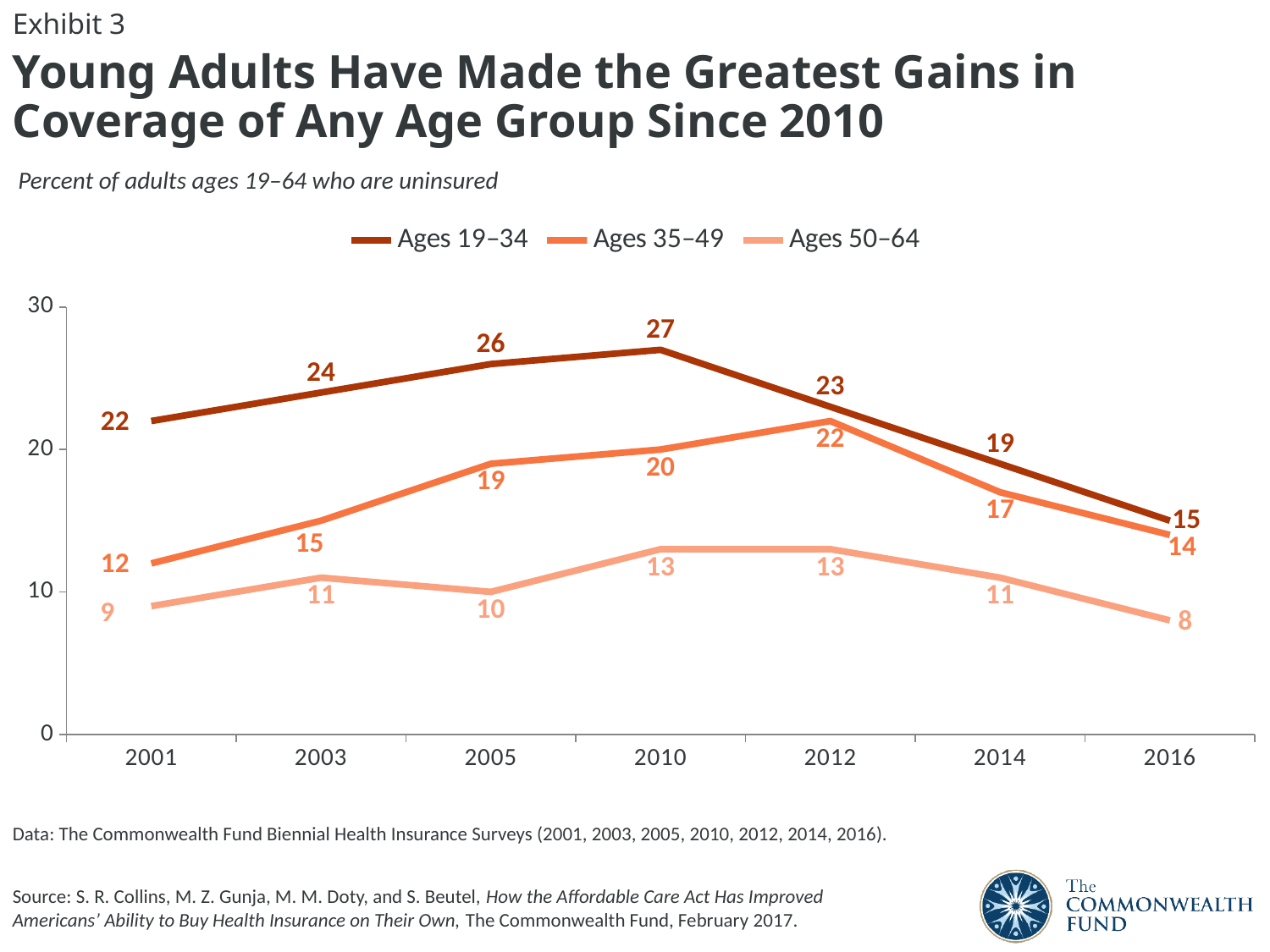
Did the Ages 35–49 uninsured rate rise or fall between 2012 and 2016? Fall How many series does the legend list? 3 By how many percentage points did the Ages 19–34 uninsured rate fall from 2010 to 2016? 12 In which year did the Ages 19–34 series reach its highest value? 2010 In which year was the Ages 50–64 series at its lowest value? 2016 How many years are shown on the x axis? 7 Which series had the higher value in 2001, Ages 19–34 or Ages 35–49? Ages 19–34 What is the difference between the Ages 35–49 and Ages 50–64 values in 2012? 9 What kind of chart is shown on the slide? Line chart What was the percent uninsured for Ages 50–64 in 2016? 8 What was the percent uninsured for Ages 19–34 in 2010? 27 What was the percent uninsured for Ages 35–49 in 2005? 19